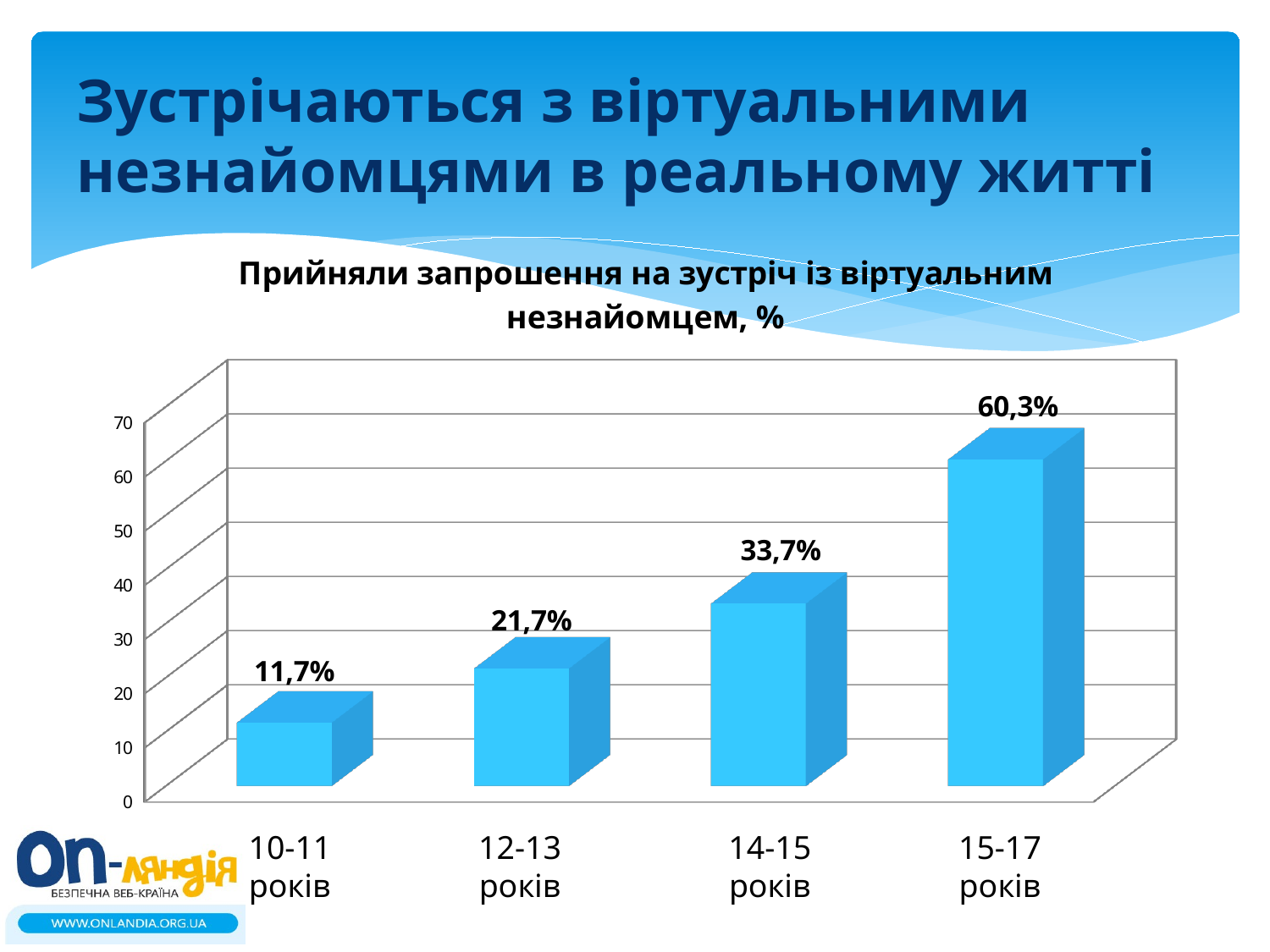
What is the value for the 14-15 років category? 33,7% What is the value for the 12-13 років category? 21,7% Which age group has the lowest value? 10-11 років Which is larger, the value for 14-15 років or the value for 12-13 років? 14-15 років How many age categories are shown in the chart? 4 What is the difference between the values for 12-13 років and 10-11 років? 10% What kind of chart is shown on the slide? Bar chart Do the values rise or fall as the age groups increase along the x axis? Rise What is the value for the 15-17 років category? 60,3% What is the value for the 10-11 років category? 11,7% Which age group has the highest value? 15-17 років What is the difference between the values for 15-17 років and 14-15 років? 26,6%